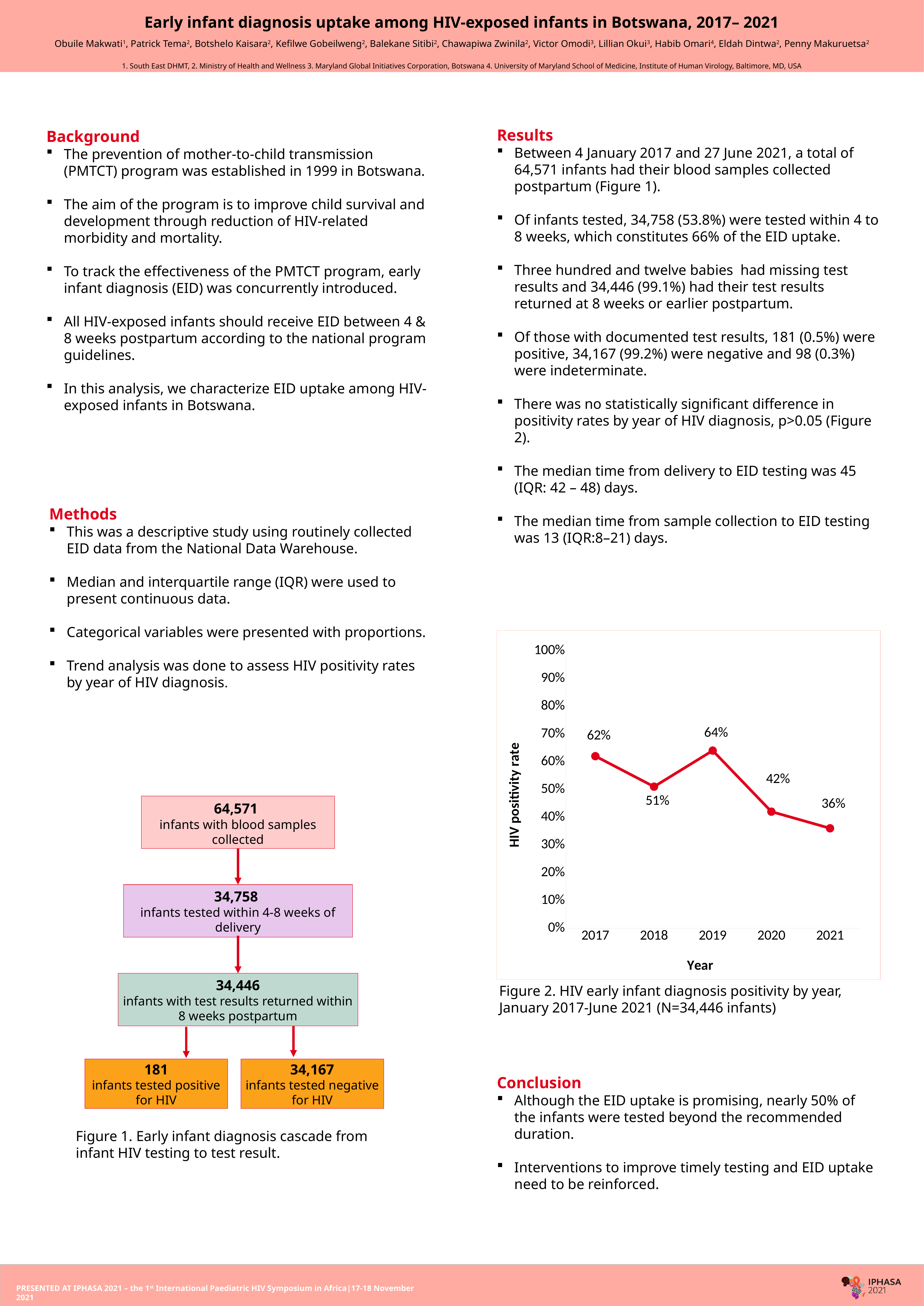
What type of chart is Figure 2 (HIV early infant diagnosis positivity by year)? line chart In Figure 2, which year has a higher HIV positivity rate, 2018 or 2020? 2018 In Figure 2, which year has the highest HIV positivity rate? 2019 In Figure 2, does the HIV positivity rate rise or fall from 2019 to 2021? fall In Figure 2, what is the HIV positivity rate for 2018? 51% In Figure 2, what is the HIV positivity rate for 2017? 62% In Figure 2, is the HIV positivity rate for 2020 greater or less than 50%? less What is the label of the vertical axis in Figure 2? HIV positivity rate In Figure 2, what is the difference in HIV positivity rate between 2019 and 2020? 22% In Figure 2, which year has the lowest HIV positivity rate? 2021 How many years are plotted in Figure 2? 5 In Figure 2, what is the HIV positivity rate for 2021? 36%